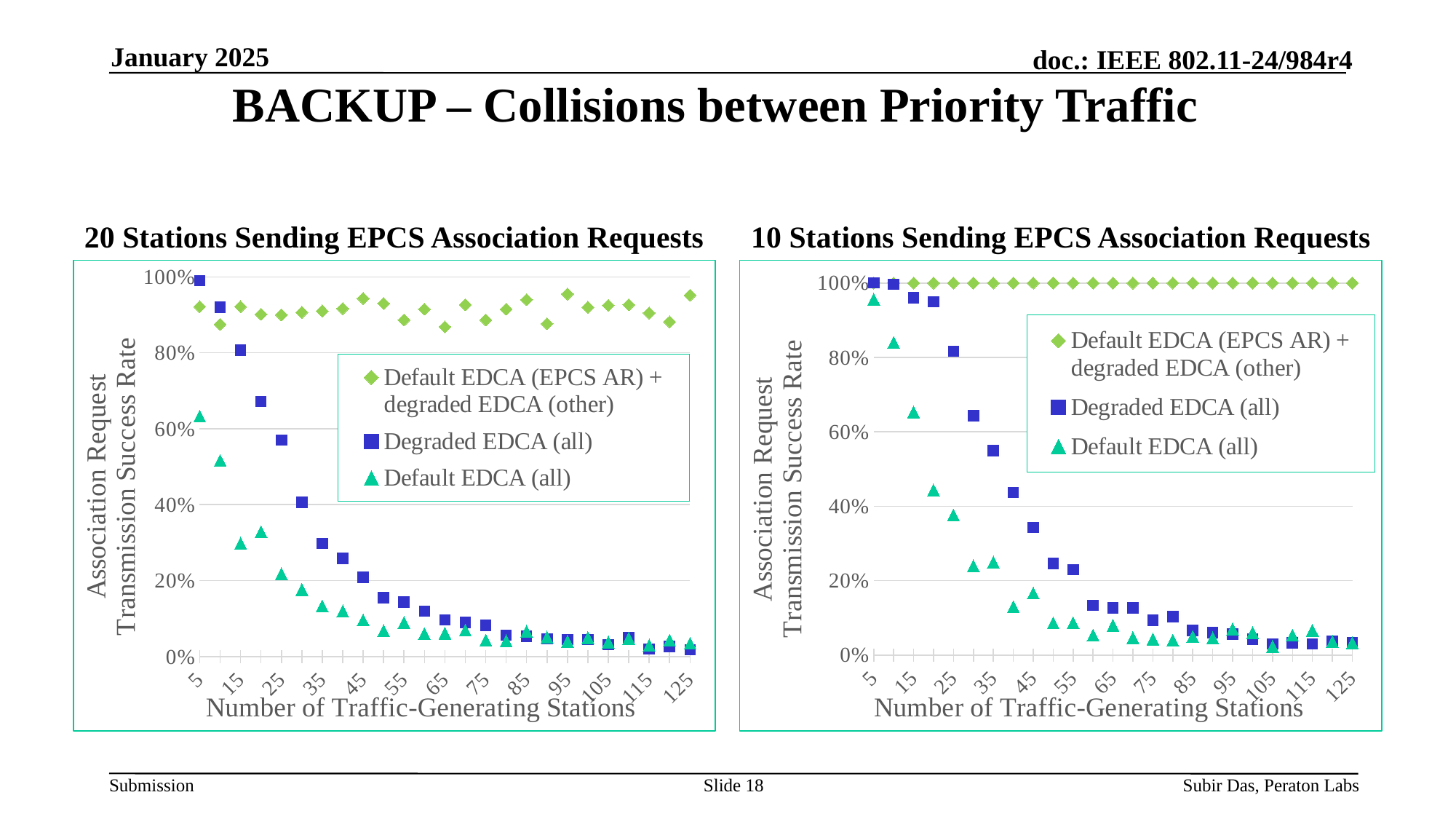
In the left chart (20 Stations Sending EPCS Association Requests), is the Degraded EDCA (all) value at 25 stations greater or less than 60%? less In the right chart (10 Stations Sending EPCS Association Requests), which series has the highest success rate across the range of stations? Default EDCA (EPCS AR) + degraded EDCA (other) In the right chart (10 Stations Sending EPCS Association Requests), is the Default EDCA (EPCS AR) + degraded EDCA (other) value at 125 stations greater or less than 80%? greater What kind of chart is the left chart titled '20 Stations Sending EPCS Association Requests'? scatter chart In the right chart (10 Stations Sending EPCS Association Requests), does the Default EDCA (EPCS AR) + degraded EDCA (other) series rise, fall, or stay roughly flat as the number of stations increases? stay roughly flat In the left chart (20 Stations Sending EPCS Association Requests), at 5 stations, which is larger: Degraded EDCA (all) or Default EDCA (all)? Degraded EDCA (all) In the left chart (20 Stations Sending EPCS Association Requests), does the Degraded EDCA (all) series rise or fall as the number of traffic-generating stations increases? fall How many series does the legend list in the right chart titled '10 Stations Sending EPCS Association Requests'? 3 What is the y-axis label of the left chart titled '20 Stations Sending EPCS Association Requests'? Association Request Transmission Success Rate In the left chart (20 Stations Sending EPCS Association Requests), is the Default EDCA (all) value at 5 stations greater or less than 60%? greater In the right chart (10 Stations Sending EPCS Association Requests), at 35 stations, which is larger: Degraded EDCA (all) or Default EDCA (all)? Degraded EDCA (all)